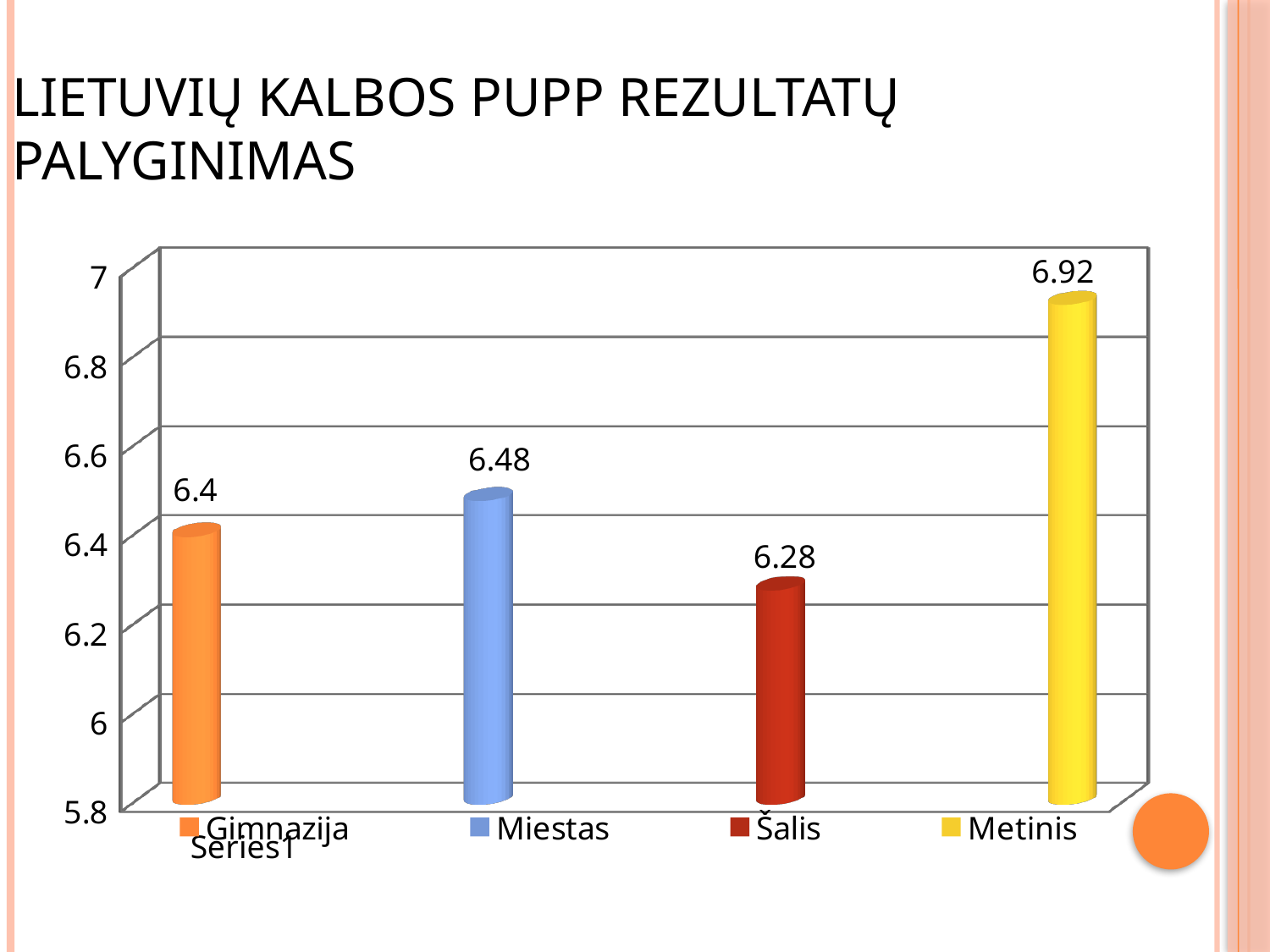
What is the difference between the values for Metinis and Šalis? 0.64 What kind of chart is shown on the slide? bar chart What is the difference between the values for Miestas and Gimnazija? 0.08 What is the value for Gimnazija? 6.4 Which is larger, the value for Gimnazija or the value for Šalis? Gimnazija What is the value for Šalis? 6.28 What colour is the bar for Metinis? yellow Which category has the highest value? Metinis Which category has the lowest value? Šalis What is the value for Metinis? 6.92 How many bars are shown in the chart? 4 What is the value for Miestas? 6.48